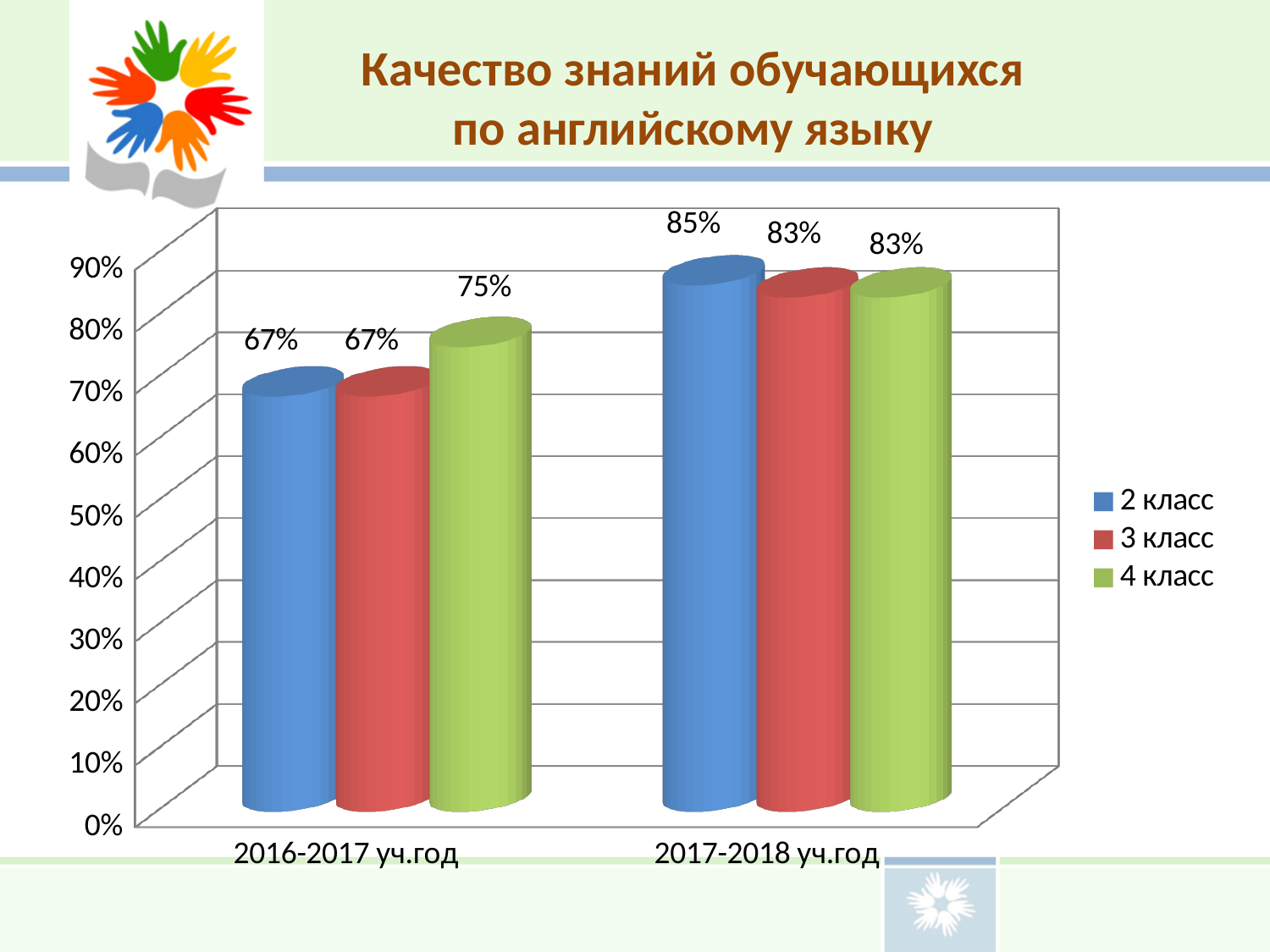
What is the value for 3 класс in 2017-2018 уч.год? 83% Which series has the highest value in 2017-2018 уч.год? 2 класс How many categories are shown on the x axis? 2 What is the difference between the 2 класс values for 2017-2018 уч.год and 2016-2017 уч.год? 18% Which is larger: the 4 класс value in 2016-2017 уч.год or the 4 класс value in 2017-2018 уч.год? 2017-2018 уч.год How many series does the legend list? 3 What is the value for 2 класс in 2017-2018 уч.год? 85% What kind of chart is shown on the slide? Bar chart Which series has the highest value in 2016-2017 уч.год? 4 класс What is the difference between the 4 класс and 2 класс values in 2016-2017 уч.год? 8% What is the value for 4 класс in 2016-2017 уч.год? 75% What is the value for 2 класс in 2016-2017 уч.год? 67%